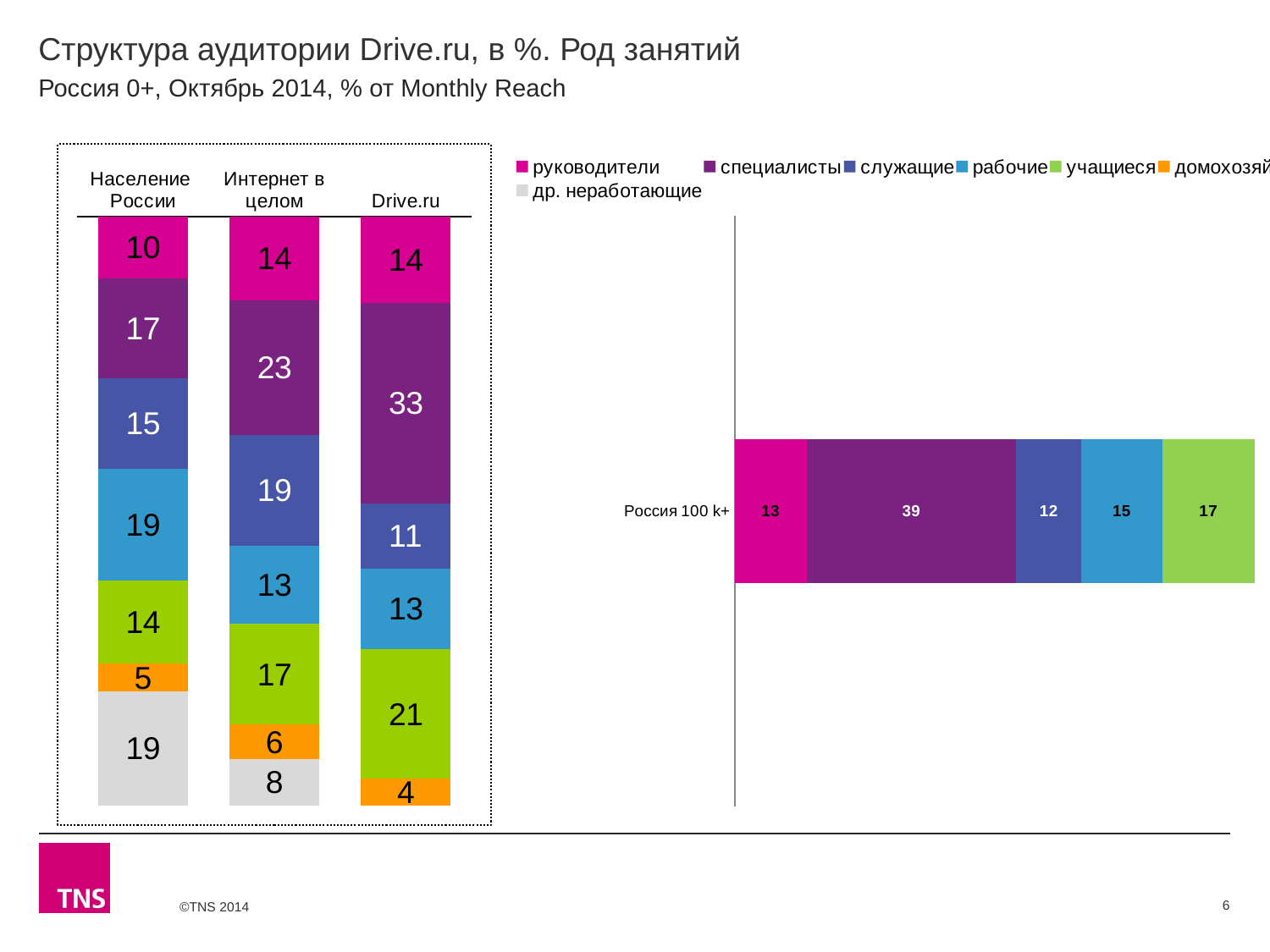
In the left chart, what is the value for служащие in the Интернет в целом bar? 19 In the left chart, which bar has the lowest value for домохозяйки? Drive.ru In the left chart, is the учащиеся value larger for Drive.ru or for Интернет в целом? Drive.ru In the right chart, what is the total of the Россия 100 k+ bar? 96 In the left chart, what is the difference between the специалисты values for Drive.ru and Население России? 16 In the left chart, which bar has the highest value for специалисты? Drive.ru In the left chart, what is the value for специалисты in the Drive.ru bar? 33 What kind of chart is the right chart? Stacked bar chart How many bars does the left chart show? 3 In the right chart, what is the value for специалисты in the Россия 100 k+ bar? 39 How many series does the legend list? 7 In the left chart, what is the value for учащиеся in the Население России bar? 14